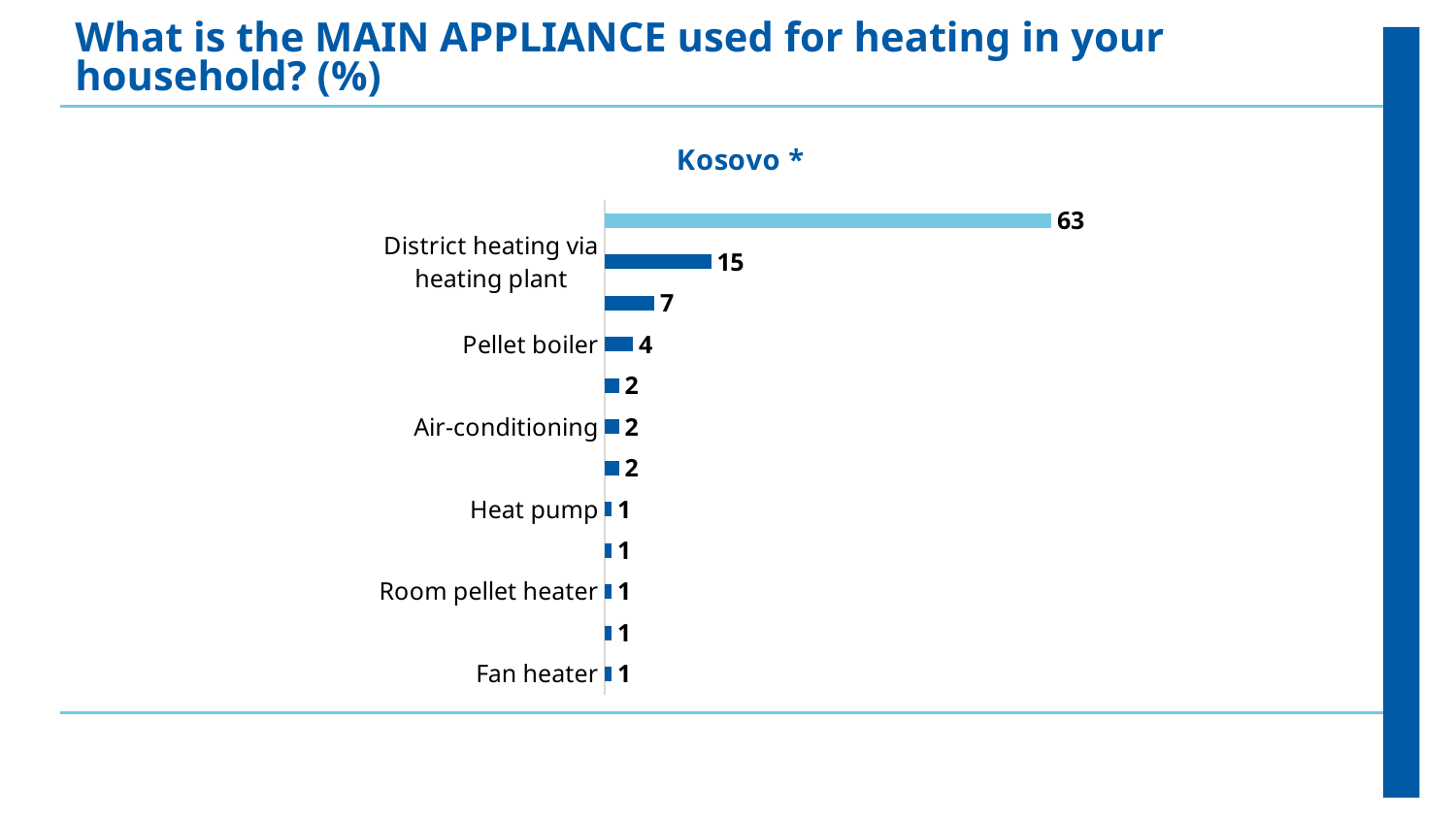
What is the value for Pellet boiler? 4 What is the value for Fan heater? 1 Do the bar values increase or decrease going from the top of the chart to the bottom? decrease What is the difference between the values for District heating via heating plant and Pellet boiler? 11 Which is larger, the value for Pellet boiler or the value for Air-conditioning? Pellet boiler What is the value for District heating via heating plant? 15 What is the value for Air-conditioning? 2 What is the value for Heat pump? 1 What type of chart is shown on the slide? bar chart How many bars are plotted in the chart? 12 What is the highest value shown in the chart? 63 What is the title of the chart? Kosovo *